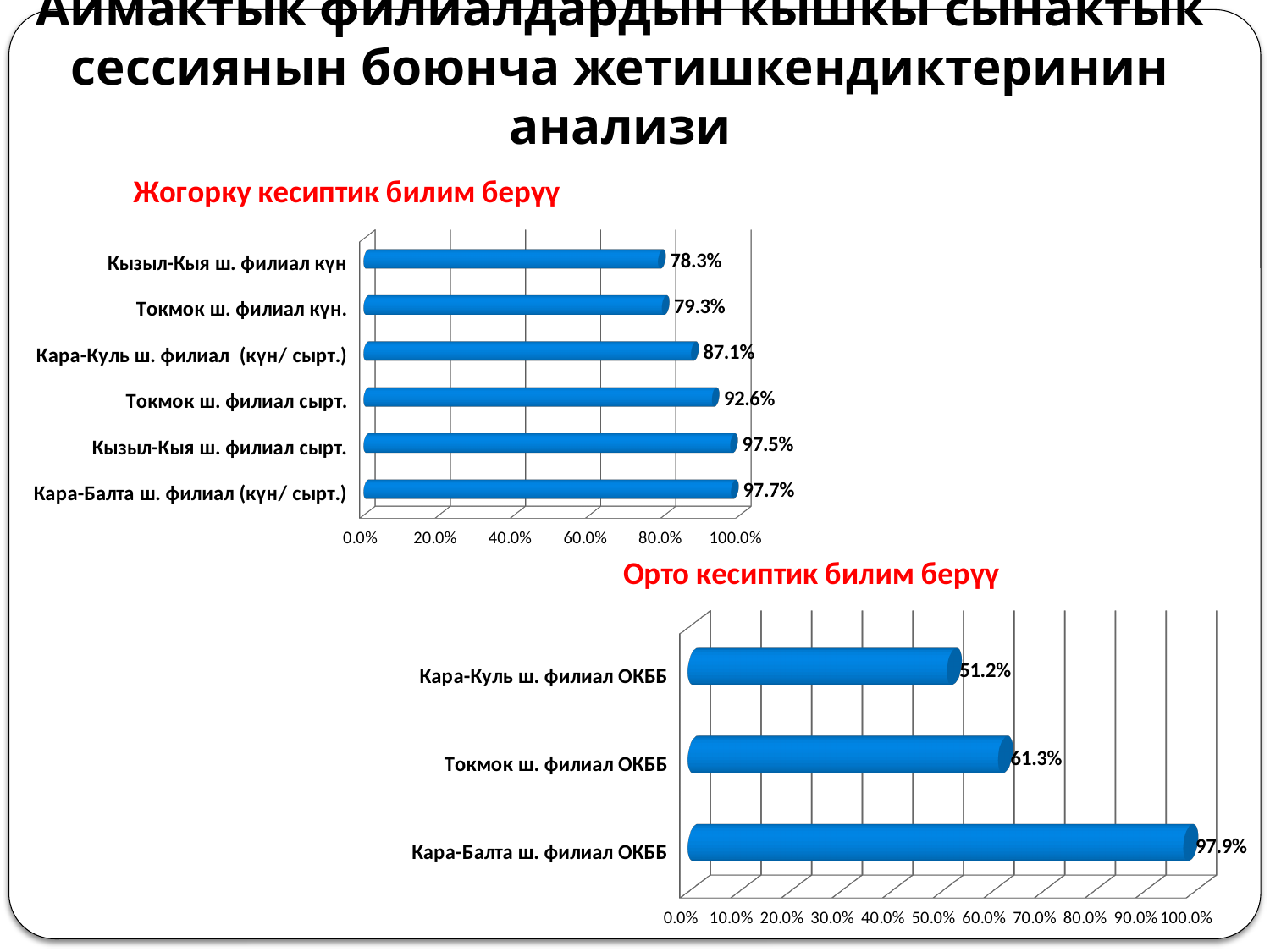
In the chart titled 'Жогорку кесиптик билим берүү', what is the value for Кара-Куль ш. филиал (күн/ сырт.)? 87.1% In the chart titled 'Жогорку кесиптик билим берүү', what is the value for Токмок ш. филиал сырт.? 92.6% In the chart titled 'Орто кесиптик билим берүү', what is the value for Токмок ш. филиал ОКББ? 61.3% How many categories are shown in the chart titled 'Орто кесиптик билим берүү'? 3 In the chart titled 'Жогорку кесиптик билим берүү', what is the difference between the values for Токмок ш. филиал сырт. and Токмок ш. филиал күн.? 13.3% In the chart titled 'Орто кесиптик билим берүү', what is the difference between the values for Кара-Балта ш. филиал ОКББ and Кара-Куль ш. филиал ОКББ? 46.7% In the chart titled 'Орто кесиптик билим берүү', is the value for Кара-Куль ш. филиал ОКББ greater or less than 60.0%? less What kind of chart is the chart titled 'Орто кесиптик билим берүү'? bar chart In the chart titled 'Орто кесиптик билим берүү', which category has the lowest value? Кара-Куль ш. филиал ОКББ In the chart titled 'Орто кесиптик билим берүү', which category has the highest value? Кара-Балта ш. филиал ОКББ How many categories are shown in the chart titled 'Жогорку кесиптик билим берүү'? 6 In the chart titled 'Жогорку кесиптик билим берүү', which is larger: the value for Кара-Куль ш. филиал (күн/ сырт.) or the value for Кызыл-Кыя ш. филиал күн? Кара-Куль ш. филиал (күн/ сырт.)